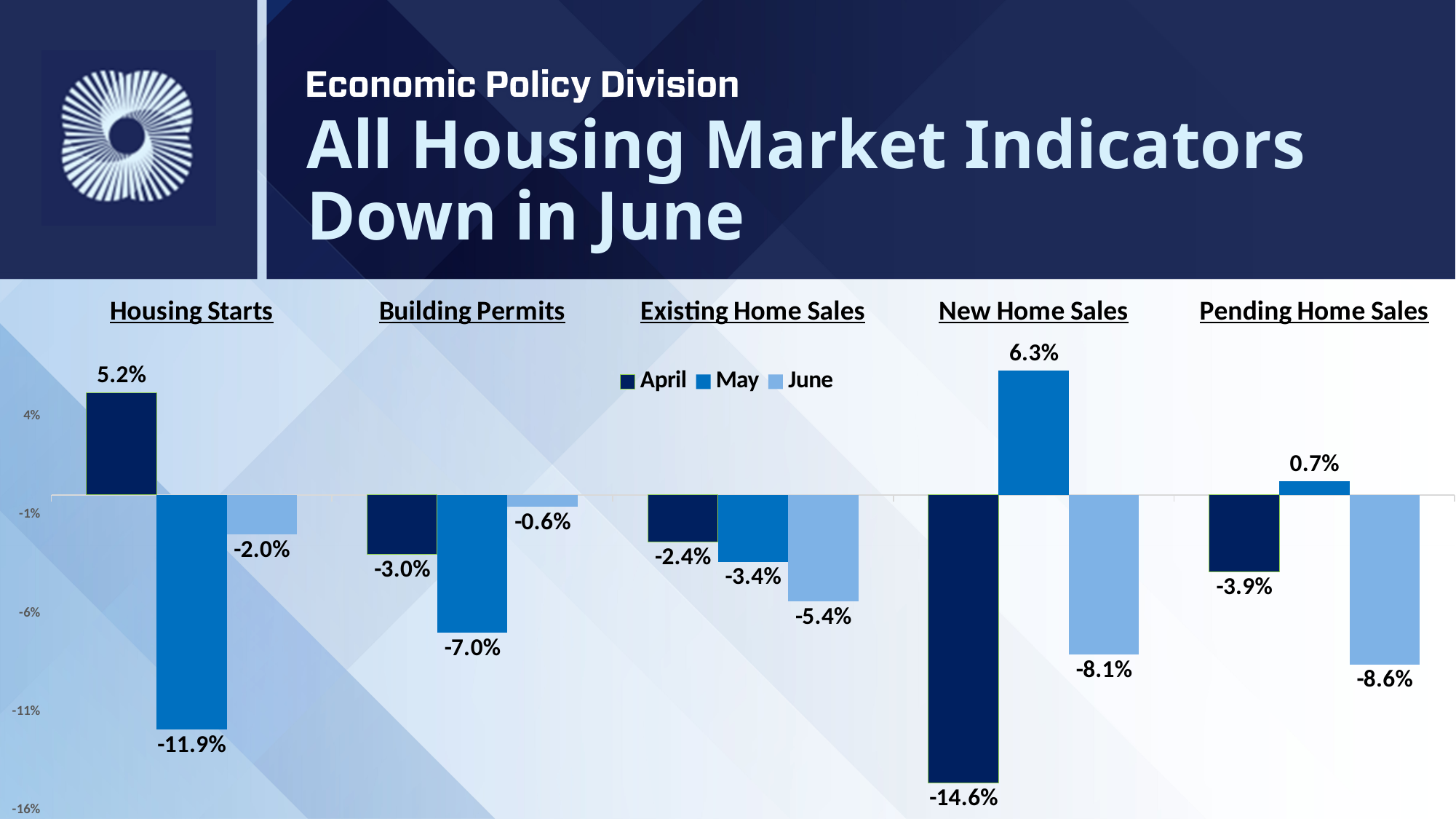
Which category has the lowest April value? New Home Sales Which is larger, the June value for New Home Sales or the June value for Pending Home Sales? New Home Sales Do the values for Existing Home Sales rise or fall from April to June? Fall What is the May value for New Home Sales? 6.3% How many categories are shown on the chart? 5 What is the difference between the May and June values for Existing Home Sales? 2.0 percentage points Which category has the highest June value? Building Permits What is the June value for Building Permits? -0.6% What is the June value for Housing Starts? -2.0% What is the April value for Pending Home Sales? -3.9% What kind of chart is shown on the slide? Bar chart How many series does the legend list? 3